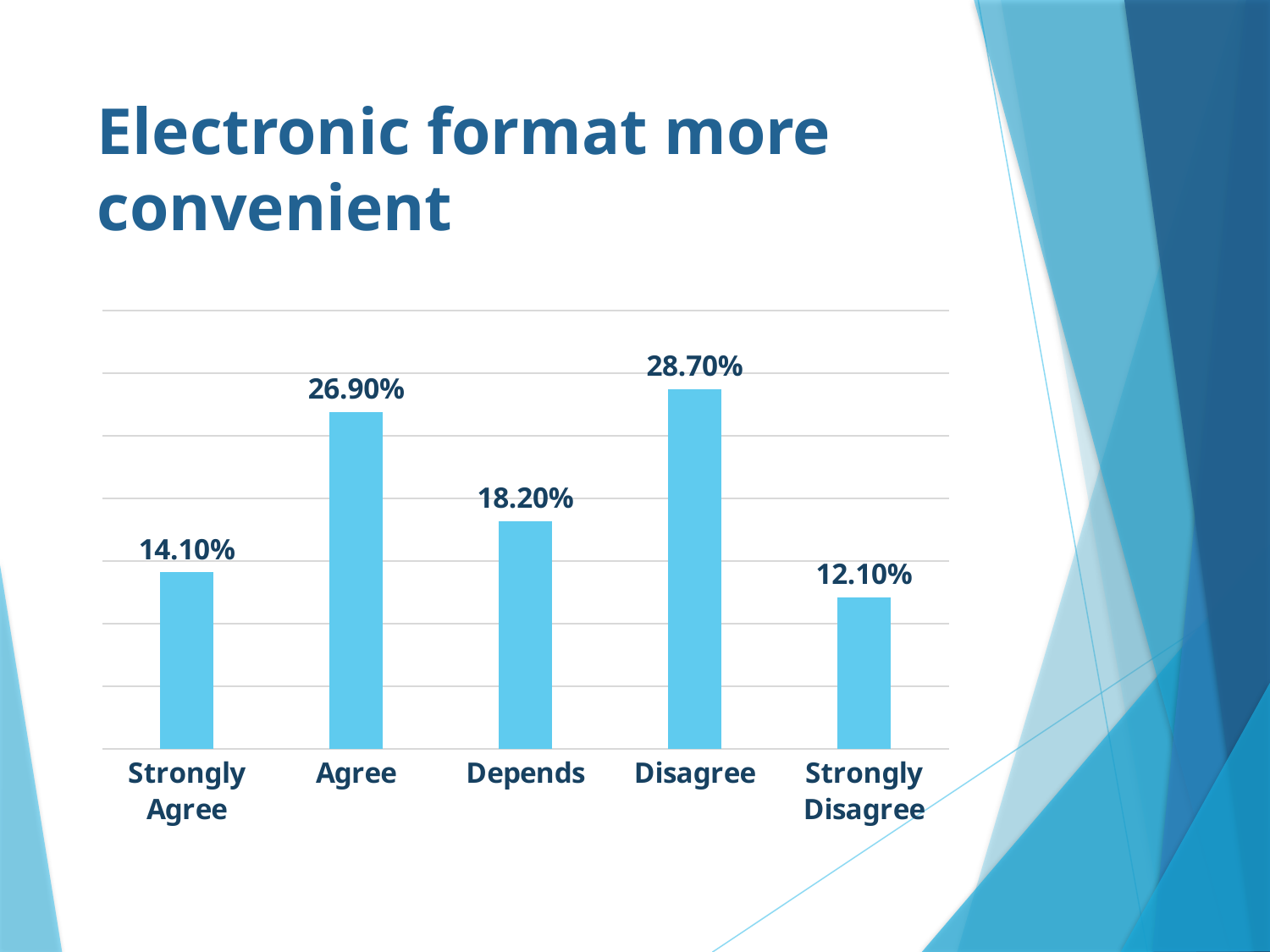
What is the value for Disagree? 28.70% What is the value for Strongly Disagree? 12.10% What kind of chart is shown on the slide? Bar chart What is the difference between the values for Depends and Strongly Agree? 4.10% Which is larger, the value for Agree or the value for Depends? Agree What is the difference between the values for Disagree and Agree? 1.80% What is the value for Strongly Agree? 14.10% What is the value for Depends? 18.20% Which category has the highest value? Disagree How many categories are shown on the x axis? 5 Which category has the lowest value? Strongly Disagree What is the value for Agree? 26.90%